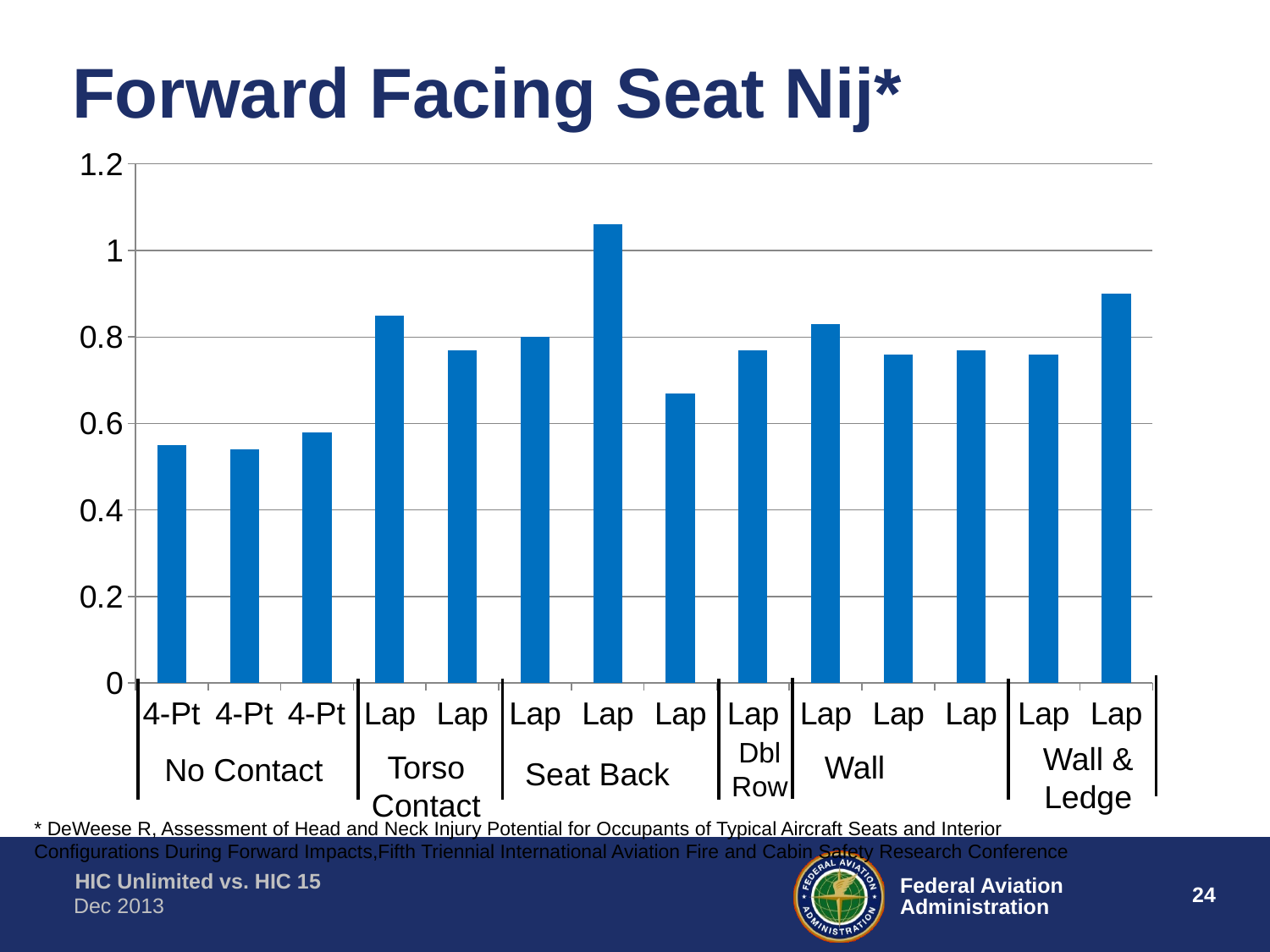
What kind of chart is shown on the slide? bar chart How many bars are plotted in the chart? 14 Is the value for the first No Contact 4-Pt bar greater or less than 0.6? less What is the title of the chart? Forward Facing Seat Nij* Is the value for the second Wall & Ledge Lap bar greater or less than 0.8? greater Which is larger: the tallest Seat Back Lap bar or the Dbl Row Lap bar? the tallest Seat Back Lap bar Which group contains the tallest bar in the chart? Seat Back How many seat configuration groups are labelled along the x axis? 6 Which group contains the lowest bars in the chart? No Contact Is the value for the tallest Seat Back Lap bar greater or less than 1? greater What is the maximum value shown on the y axis? 1.2